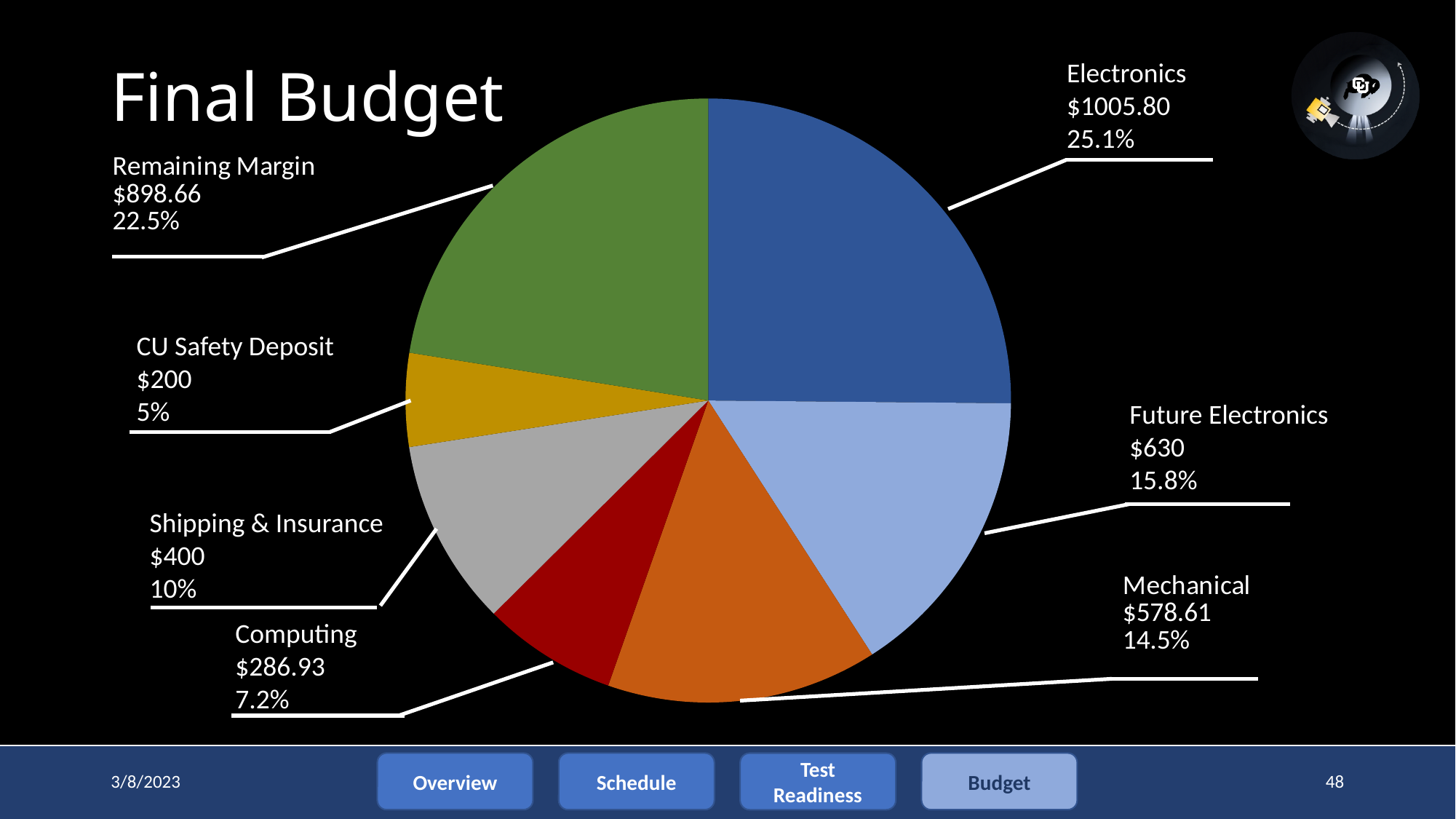
What is the difference in dollars between Shipping & Insurance and CU Safety Deposit? $200 Which category has the largest slice of the pie? Electronics Which is larger, Future Electronics or Mechanical? Future Electronics What share of the pie does Computing represent? 7.2% What kind of chart is shown on the slide? pie chart What is the dollar value for Electronics? $1005.80 What is the dollar value for Mechanical? $578.61 What percentage of the budget is Remaining Margin? 22.5% How many categories are shown in the pie chart? 7 Which category has the smallest slice of the pie? CU Safety Deposit What is the difference in percentage points between Electronics and Remaining Margin? 2.6% What is the title of the chart? Final Budget